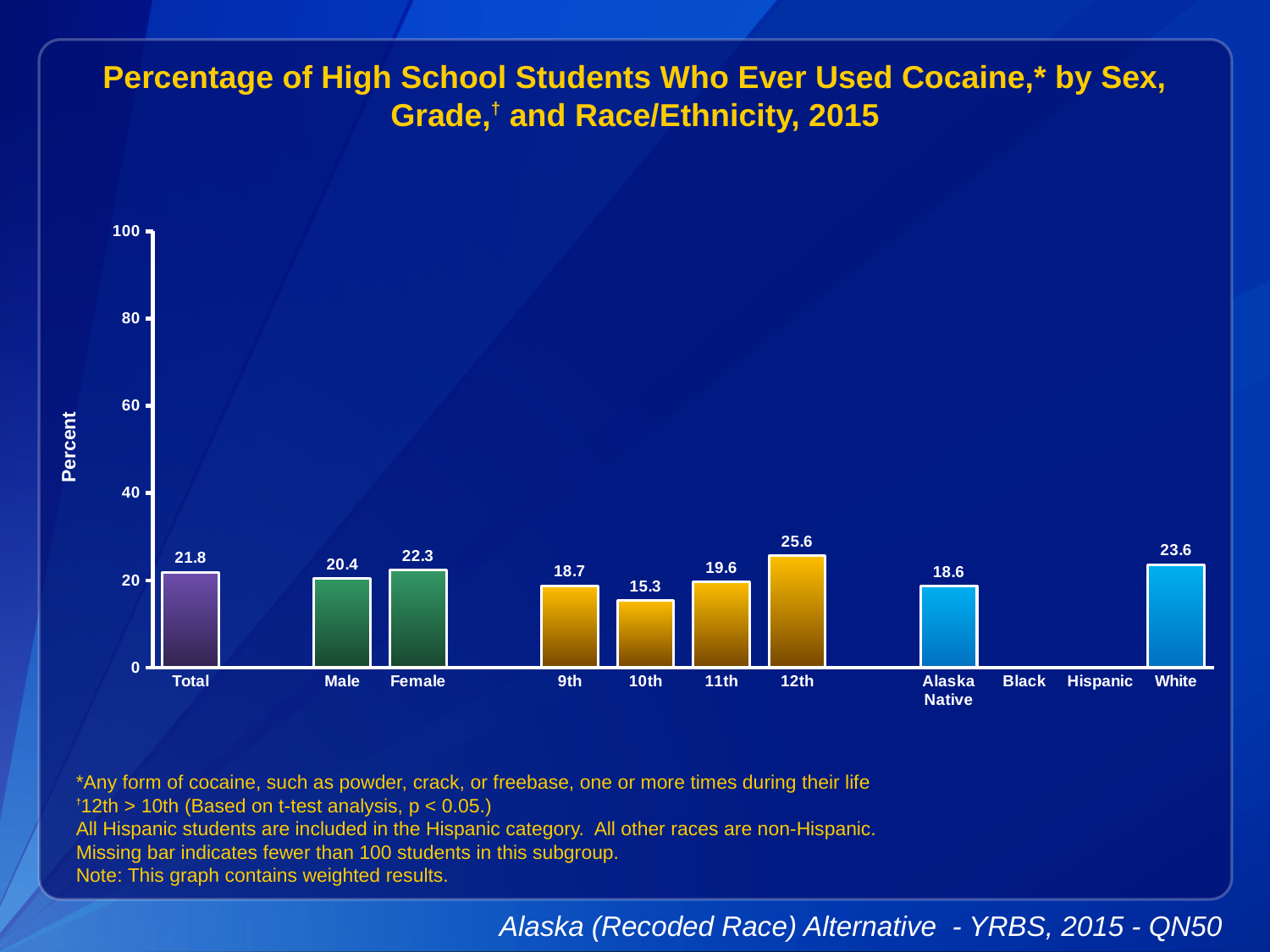
What is the value for Female? 22.3 What is the value for 10th grade? 15.3 Which category has the highest value? 12th What is the value for Alaska Native? 18.6 Is the value for White greater or less than 20? greater What kind of chart is this? bar chart How many categories have a bar shown? 9 Which is larger, the value for Male or the value for Female? Female Which categories have no bar shown? Black and Hispanic Which category with a bar has the lowest value? 10th What is the value for Total? 21.8 What is the difference between the values for 12th and 10th grade? 10.3